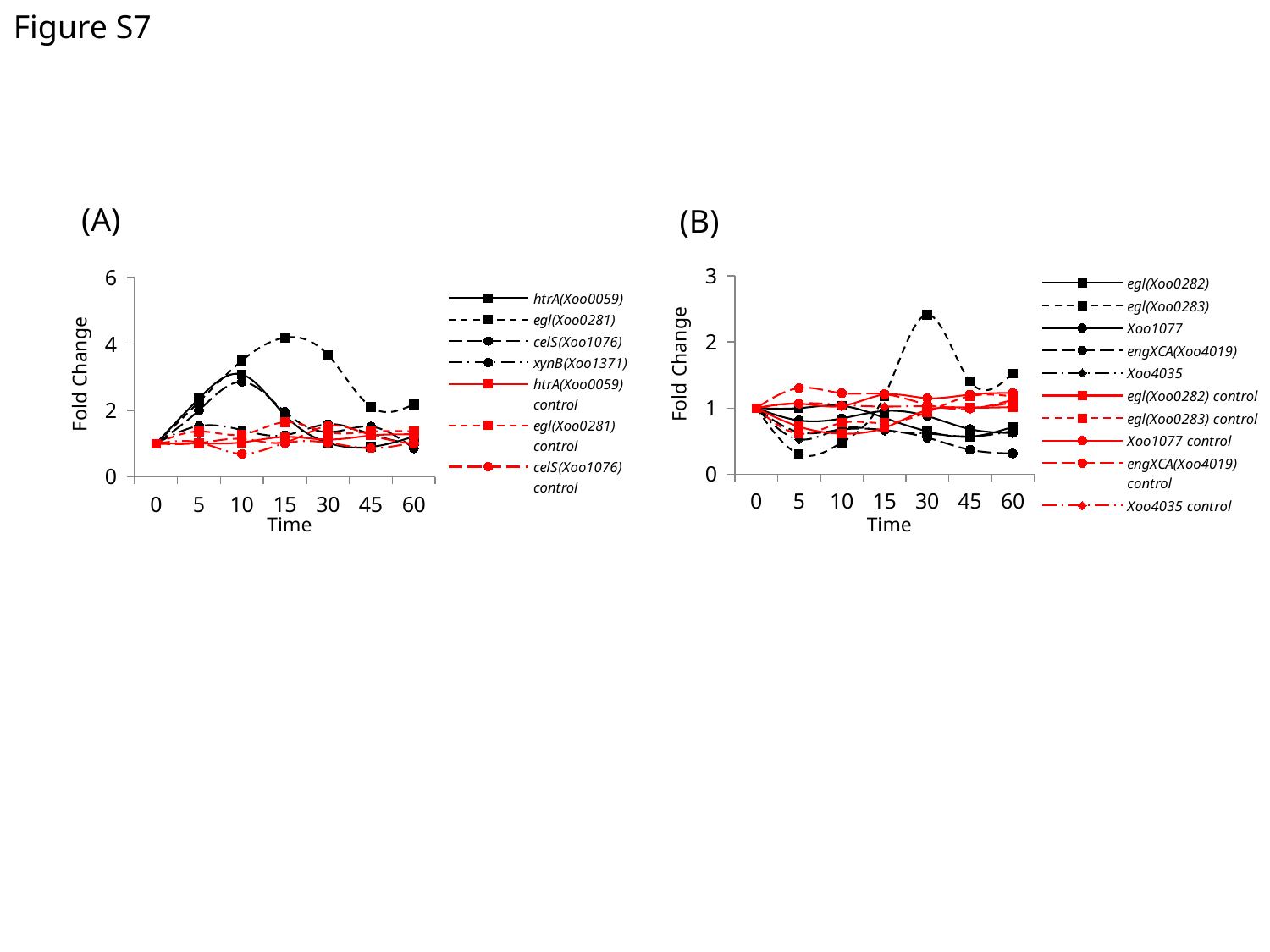
How many series does the legend of chart (B) list? 10 In chart (A), at time 15, which is larger: egl(Xoo0281) or htrA(Xoo0059)? egl(Xoo0281) In chart (A), is the value for egl(Xoo0281) at time 15 greater or less than 4? greater What is the label of the y axis in chart (B)? Fold Change In chart (B), is the value for egl(Xoo0283) at time 30 greater or less than 2? greater What kind of chart is chart (A)? line chart How many series does the legend of chart (A) list? 7 In chart (B), which series reaches the highest fold change? egl(Xoo0283) In chart (A), which series reaches the highest fold change? egl(Xoo0281) In chart (B), is the value for egl(Xoo0283) at time 5 greater or less than 1? less How many time points are shown on the x axis of chart (B)? 7